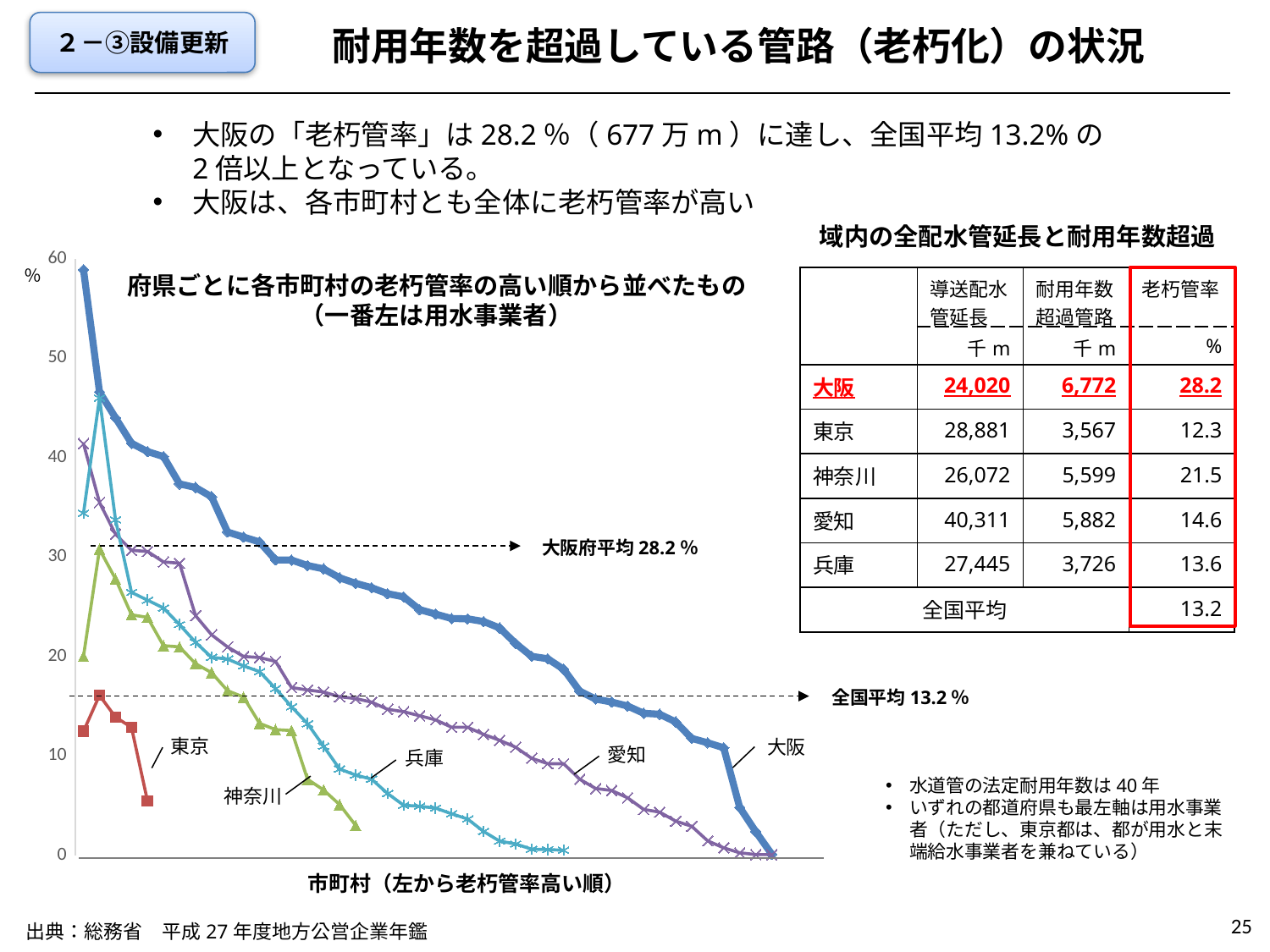
What kind of chart is shown on the left of the slide? line chart In the line chart, is the highest value for 東京 greater or less than 20? less In the line chart, is the leftmost value for 大阪 greater or less than 50? greater In the line chart, is the highest value for 兵庫 greater or less than 40? greater What is the x-axis label of the line chart? 市町村（左から老朽管率高い順） Which prefecture's line has the lowest peak value in the line chart? 東京 How many prefecture series are plotted in the line chart? 5 What value does the dashed line labelled 大阪府平均 mark in the line chart? 28.2% In the line chart, do the values for each prefecture rise or fall from left to right along the x axis? fall In the line chart, which is larger: the leftmost value for 大阪 or the leftmost value for 兵庫? 大阪 What is the difference between the 大阪府平均 (28.2%) and the 全国平均 (13.2%) shown as dashed lines in the line chart? 15.0% Which prefecture's line reaches the highest value in the line chart? 大阪